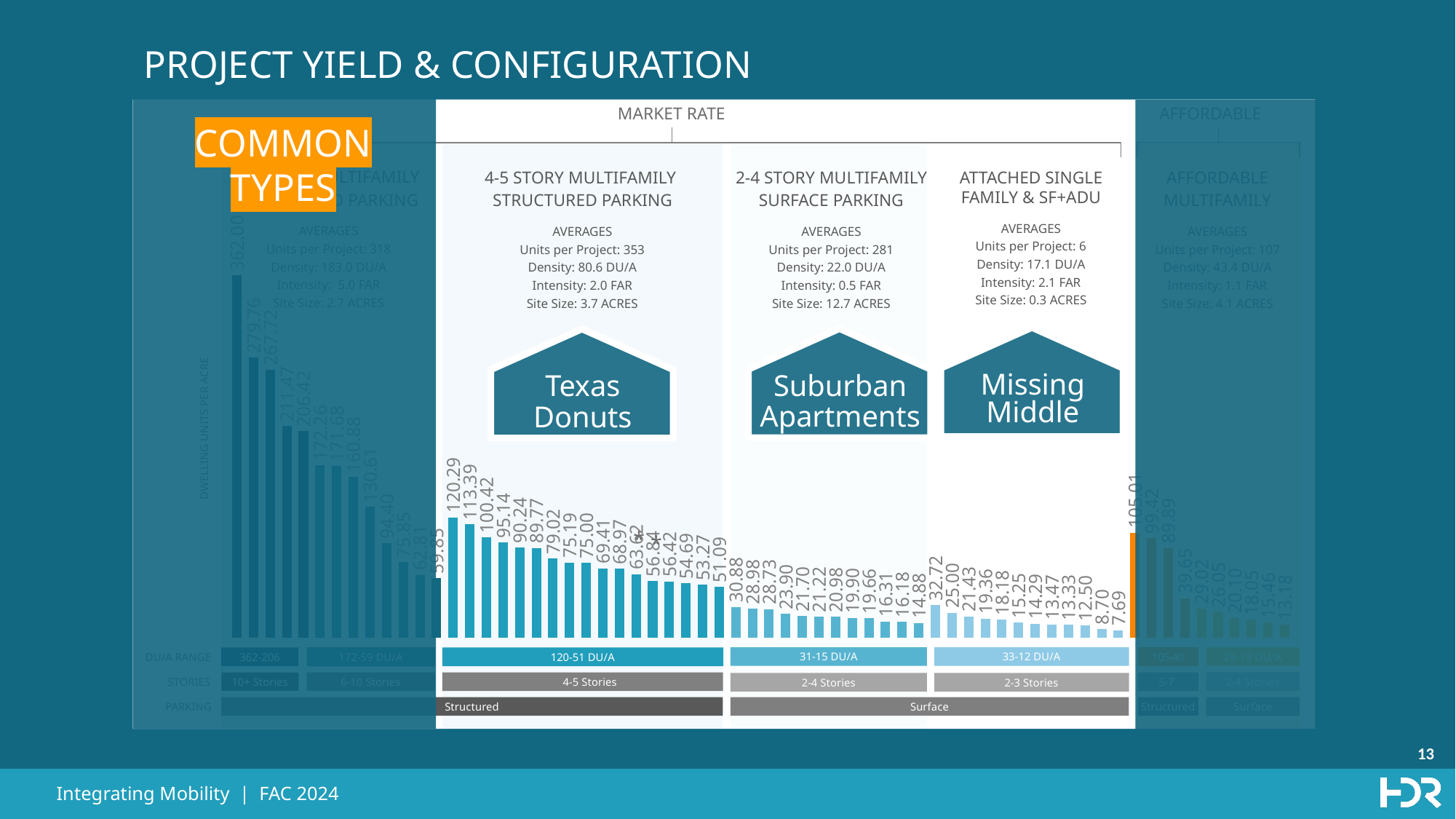
What DU/A range is shown below the Texas Donuts group of bars? 120-51 DU/A Which is larger: the tallest Missing Middle bar (32.72) or the tallest Suburban Apartments bar (30.88)? Missing Middle (32.72) What is the label on the vertical axis of the chart? Dwelling Units per Acre What is the highest value among the Texas Donuts (4-5 story multifamily structured parking) bars? 120.29 How many bars are in the Suburban Apartments (2-4 story multifamily surface parking) group? 12 What is the highest value among the Suburban Apartments (2-4 story multifamily surface parking) bars? 30.88 How many bars are in the Missing Middle (attached single family & SF+ADU) group? 12 Within the Texas Donuts group, do the bar values rise or fall from left to right? fall What is the lowest value among the Texas Donuts (4-5 story multifamily structured parking) bars? 51.09 What kind of chart is shown on the slide? bar chart What is the difference between the two tallest Texas Donuts bars, 120.29 and 113.39? 6.90 What is the lowest value among the Missing Middle (attached single family & SF+ADU) bars? 7.69